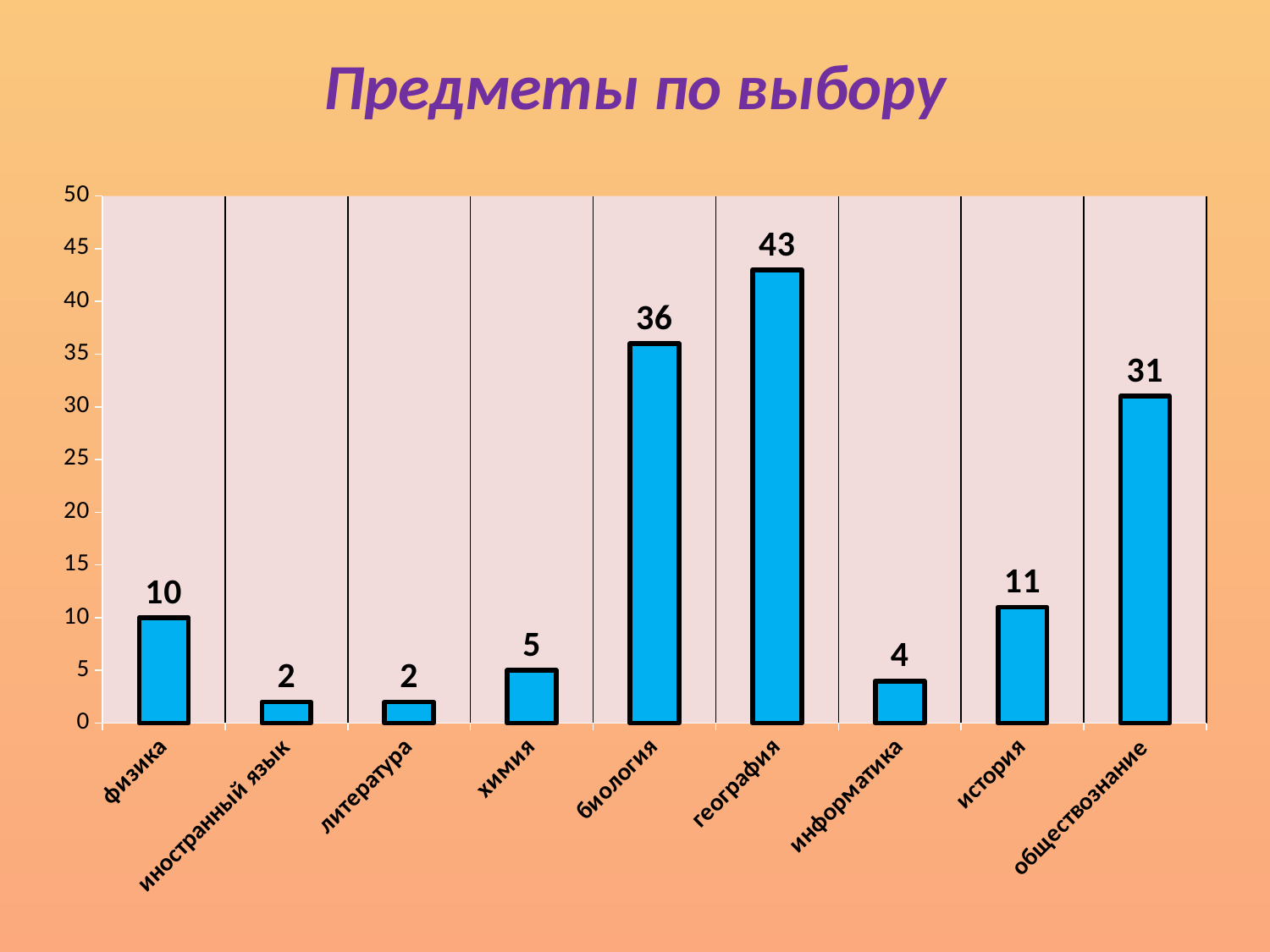
Which category has the highest value? география What is the value for информатика? 4 What is the difference between the values for география and биология? 7 What kind of chart is shown? bar chart What is the title of the chart? Предметы по выбору What is the value for география? 43 What is the difference between the values for обществознание and история? 20 How many categories are shown on the x axis? 9 What is the value for физика? 10 Is the value for биология greater or less than 30? greater Which is larger, the value for история or the value for химия? история What is the value for обществознание? 31